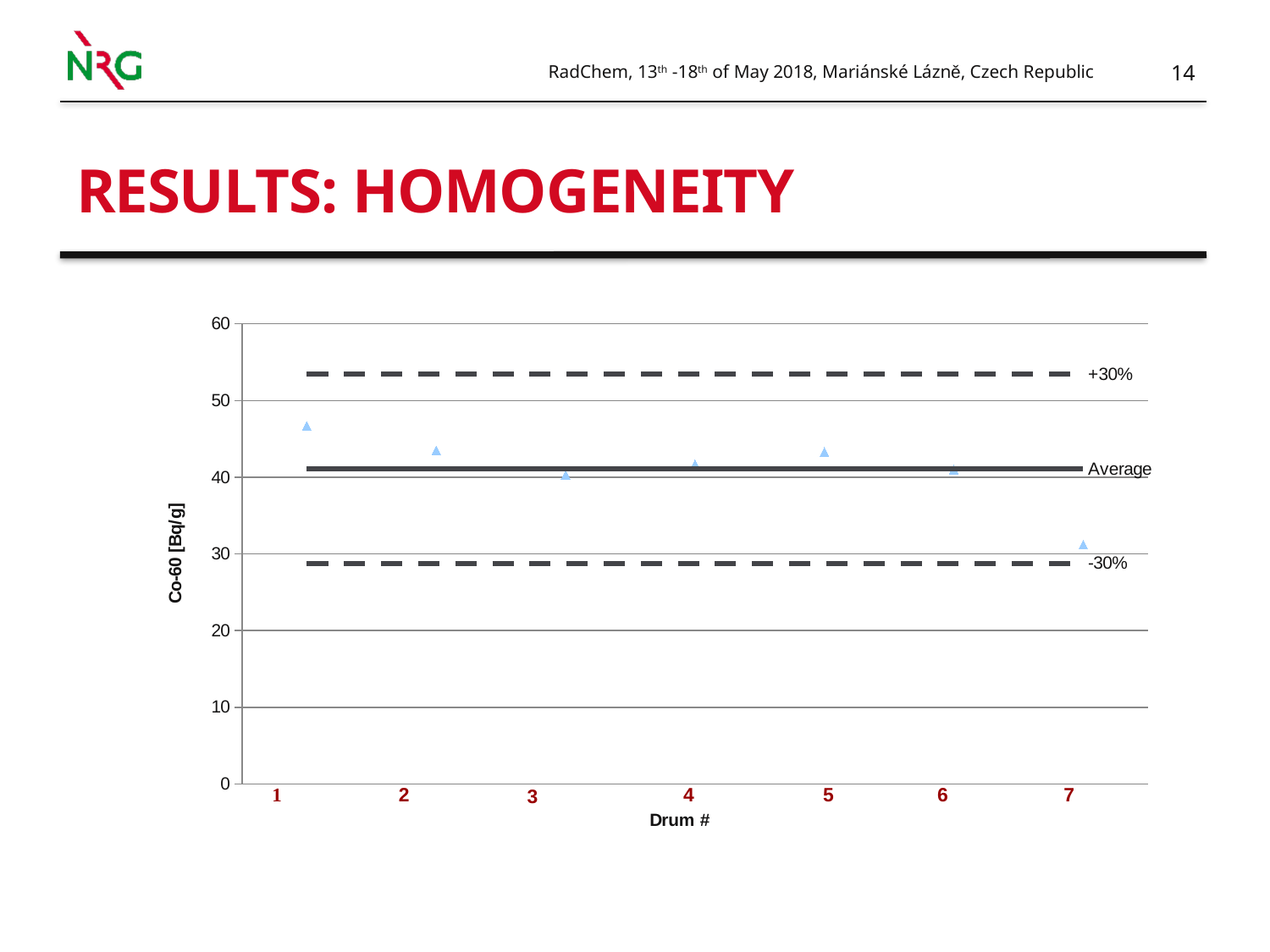
Is the Co-60 value for drum 2 greater or less than 50? less Which drum has the lowest Co-60 value? Drum 7 Which has the larger Co-60 value, drum 3 or drum 7? Drum 3 What is the label of the y axis? Co-60 [Bq/g] What are the three horizontal reference lines labelled? +30%, Average, -30% Is the Co-60 value for drum 1 greater or less than 40? greater Is the Co-60 value for drum 7 greater or less than 30? greater Which has the larger Co-60 value, drum 1 or drum 7? Drum 1 How many drums are plotted on the x axis? 7 Which drum has the highest Co-60 value? Drum 1 What kind of chart is shown on the slide? scatter chart